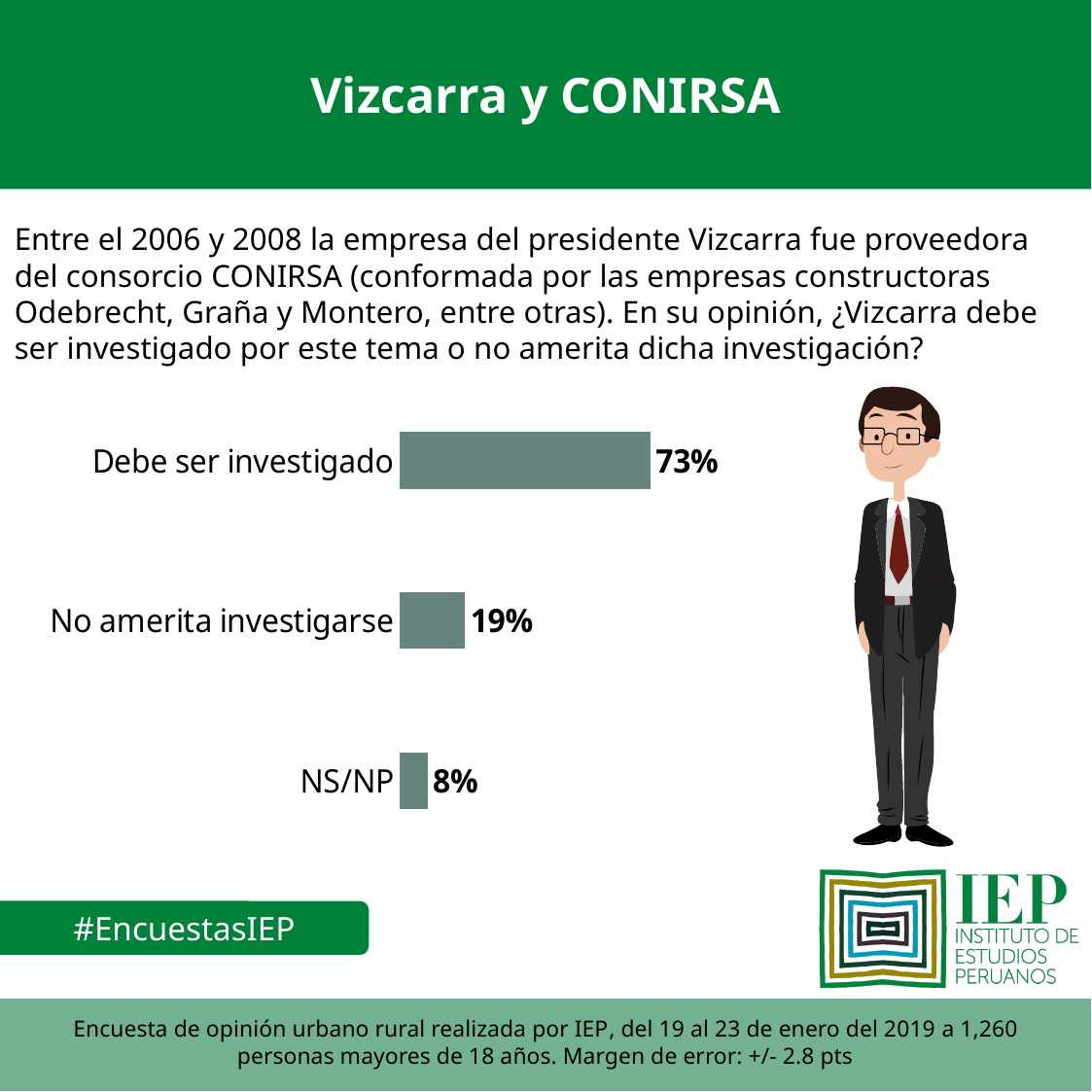
What percentage of respondents said Vizcarra "Debe ser investigado"? 73% What is the title of the slide containing the chart? Vizcarra y CONIRSA What percentage of respondents answered "NS/NP"? 8% What percentage of respondents answered "No amerita investigarse"? 19% Which is larger: the value for "No amerita investigarse" or the value for "NS/NP"? No amerita investigarse Which response category has the highest percentage? Debe ser investigado What is the difference in percentage points between "No amerita investigarse" and "NS/NP"? 11 What is the margin of error stated for the survey? +/- 2.8 pts How many response categories are shown in the chart? 3 What is the difference in percentage points between "Debe ser investigado" and "No amerita investigarse"? 54 Which response category has the lowest percentage? NS/NP What kind of chart is shown on the slide? Bar chart